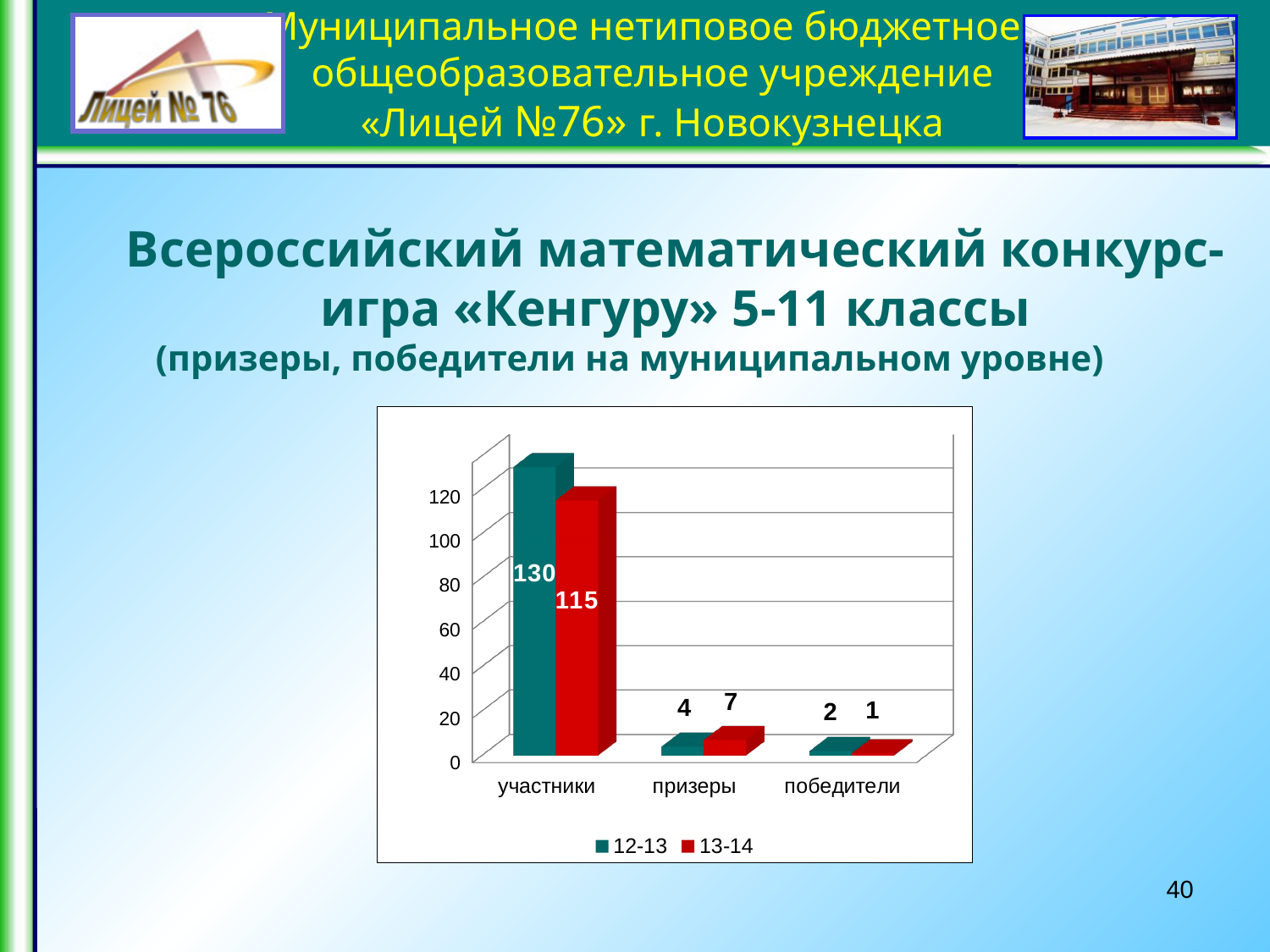
Which series is shown in red in the legend? 13-14 Which category has the lowest value in the 13-14 series? победители What kind of chart is shown on the slide? bar chart What is the value for участники in the 12-13 series? 130 Which category has the highest value in the 13-14 series? участники How many series does the legend list? 2 How many categories are shown on the x axis? 3 What is the value for победители in the 12-13 series? 2 For призеры, which series has the larger value, 12-13 or 13-14? 13-14 What is the value for участники in the 13-14 series? 115 What is the difference between the 12-13 and 13-14 values for участники? 15 What is the value for призеры in the 13-14 series? 7